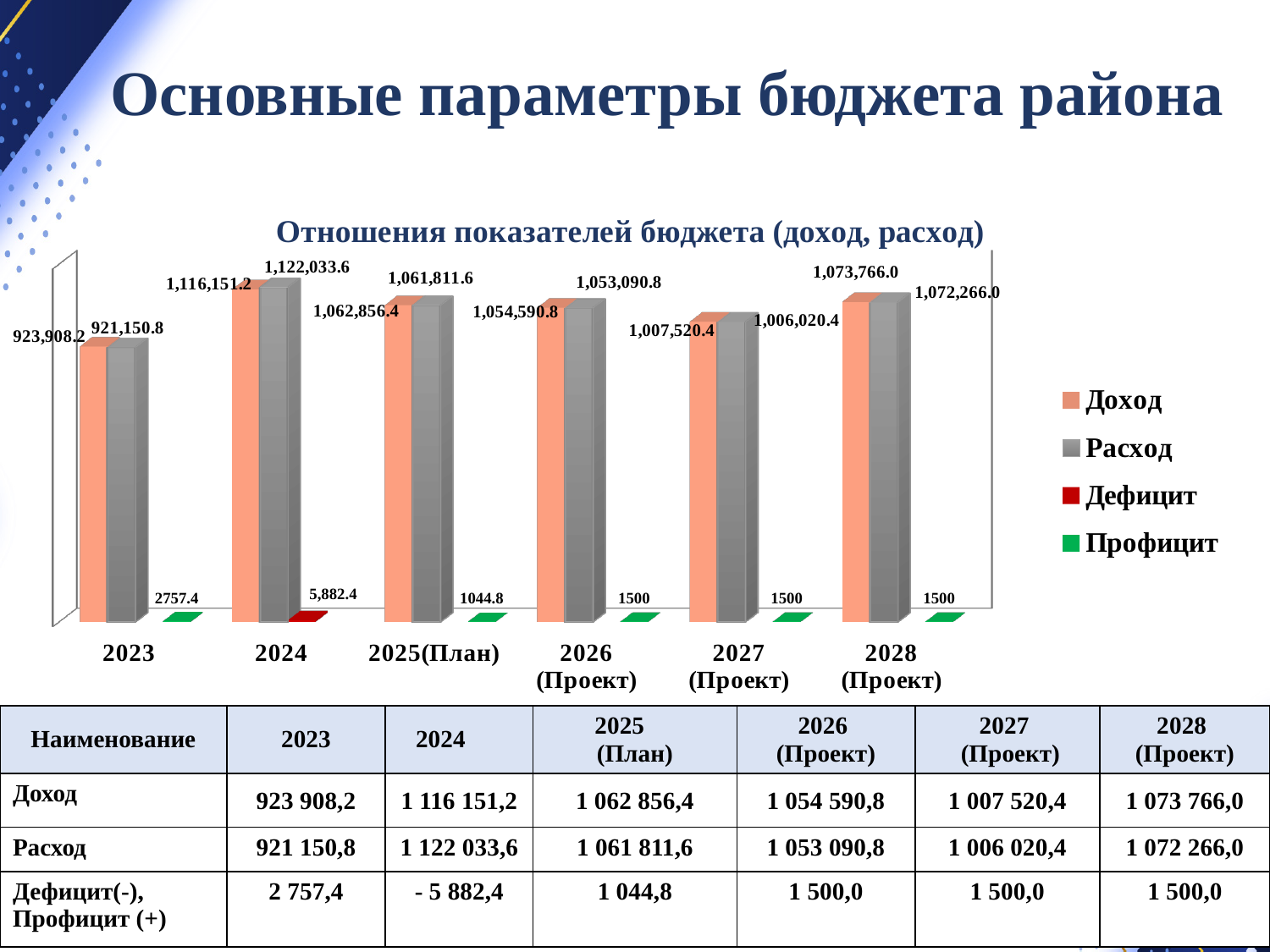
How many series does the legend list? 4 What is the value of Расход for 2024? 1,122,033.6 How many year categories are shown on the x axis? 6 What is the value of Доход for 2023? 923,908.2 In which year is Доход the highest? 2024 What is the value of Доход for 2028 (Проект)? 1,073,766.0 In which year is Расход the lowest? 2023 What is the title of the chart? Отношения показателей бюджета (доход, расход) What is the value of Расход for 2027 (Проект)? 1,006,020.4 In 2024, which is larger: Доход or Расход? Расход What kind of chart is shown on the slide? Bar chart What is the difference between Доход and Расход in 2023? 2,757.4